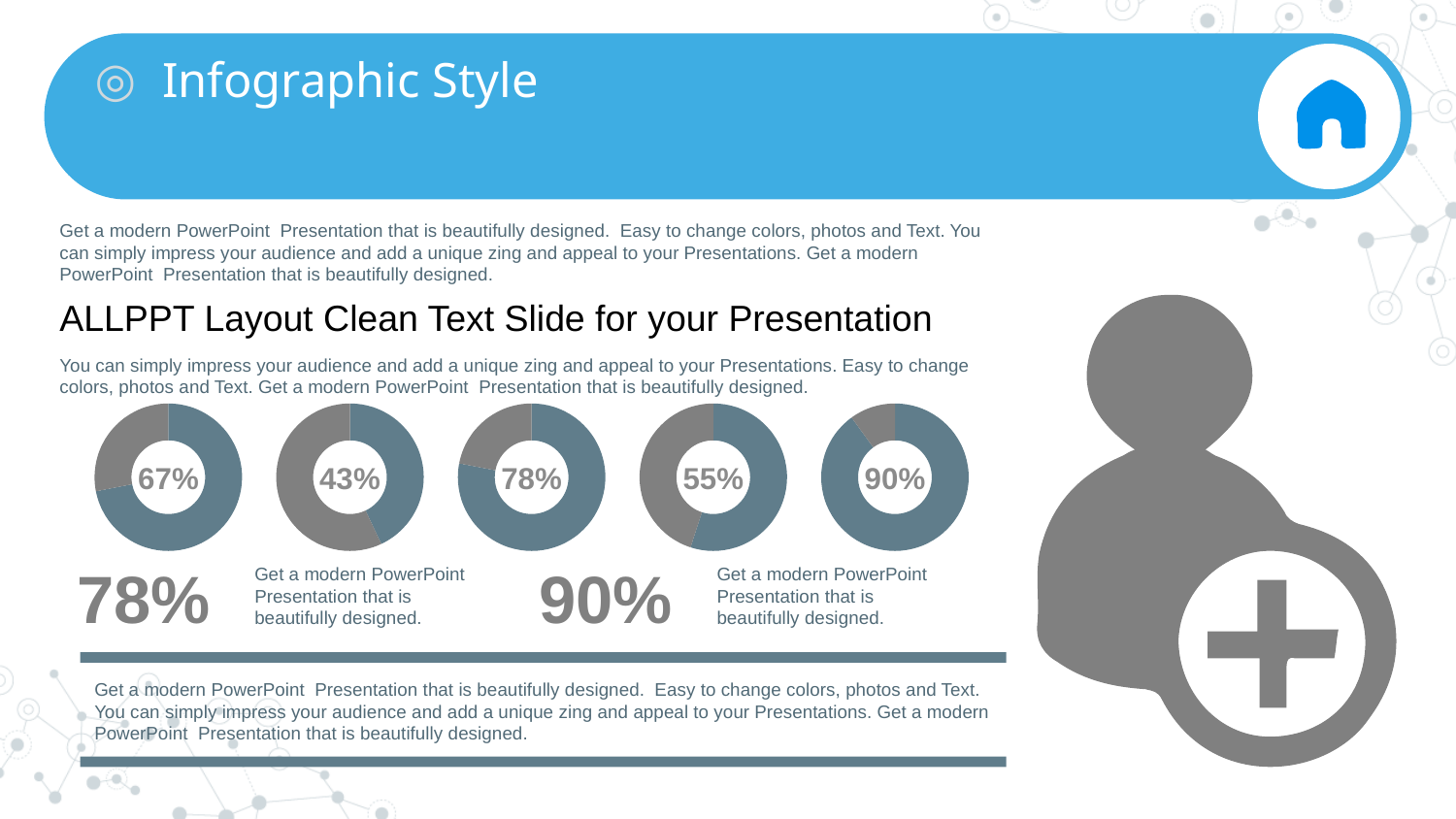
What kind of chart is used for the five small charts in the middle of the slide? Donut chart Which donut chart shows the highest percentage? The rightmost one, 90% Which donut chart shows the lowest percentage? The second from the left, 43% What value is shown in the fifth (rightmost) donut chart? 90% Which is larger, the value in the third donut chart or the value in the fourth donut chart? The third donut chart (78%) What value is shown in the middle (third) donut chart? 78% What value is shown in the first (leftmost) donut chart? 67% What value is shown in the second donut chart from the left? 43% What value is shown in the fourth donut chart from the left? 55% What is the difference between the values in the rightmost donut chart and the leftmost donut chart? 23% Is the value in the second donut chart from the left greater or less than 50%? less How many donut charts are shown on the slide? 5